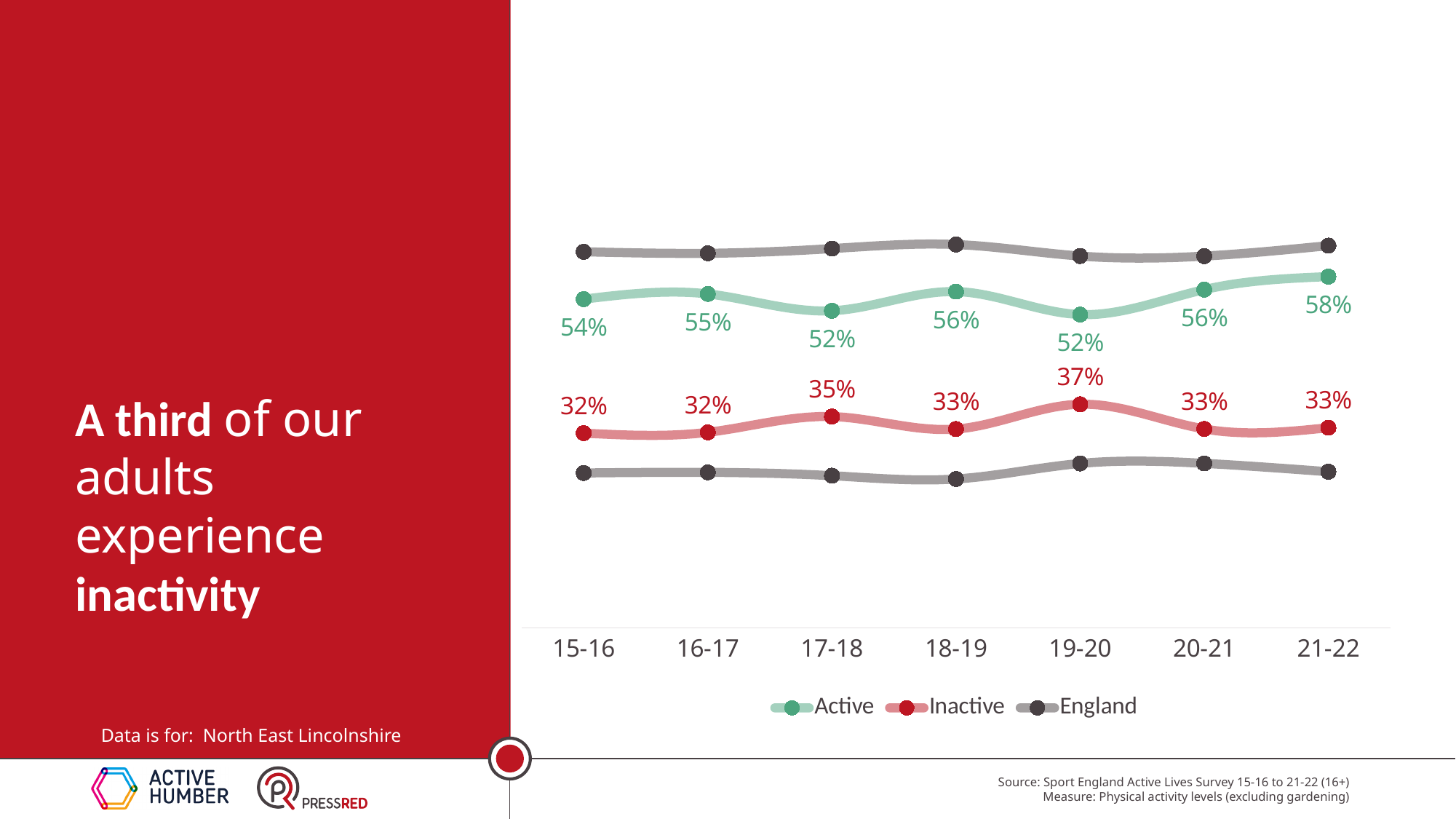
In which year is the Inactive value highest? 19-20 What is the difference between the Active and Inactive values in 21-22? 25% What kind of chart is shown on the slide? line chart What is the Inactive value for 15-16? 32% What is the Active value for 21-22? 58% Which is larger, the Inactive value in 17-18 or the Inactive value in 18-19? 17-18 What is the Active value for 17-18? 52% How many years are shown on the x axis? 7 What is the Inactive value for 19-20? 37% In which year is the Active value highest? 21-22 What colour is the Inactive line? red How many series does the legend list? 3